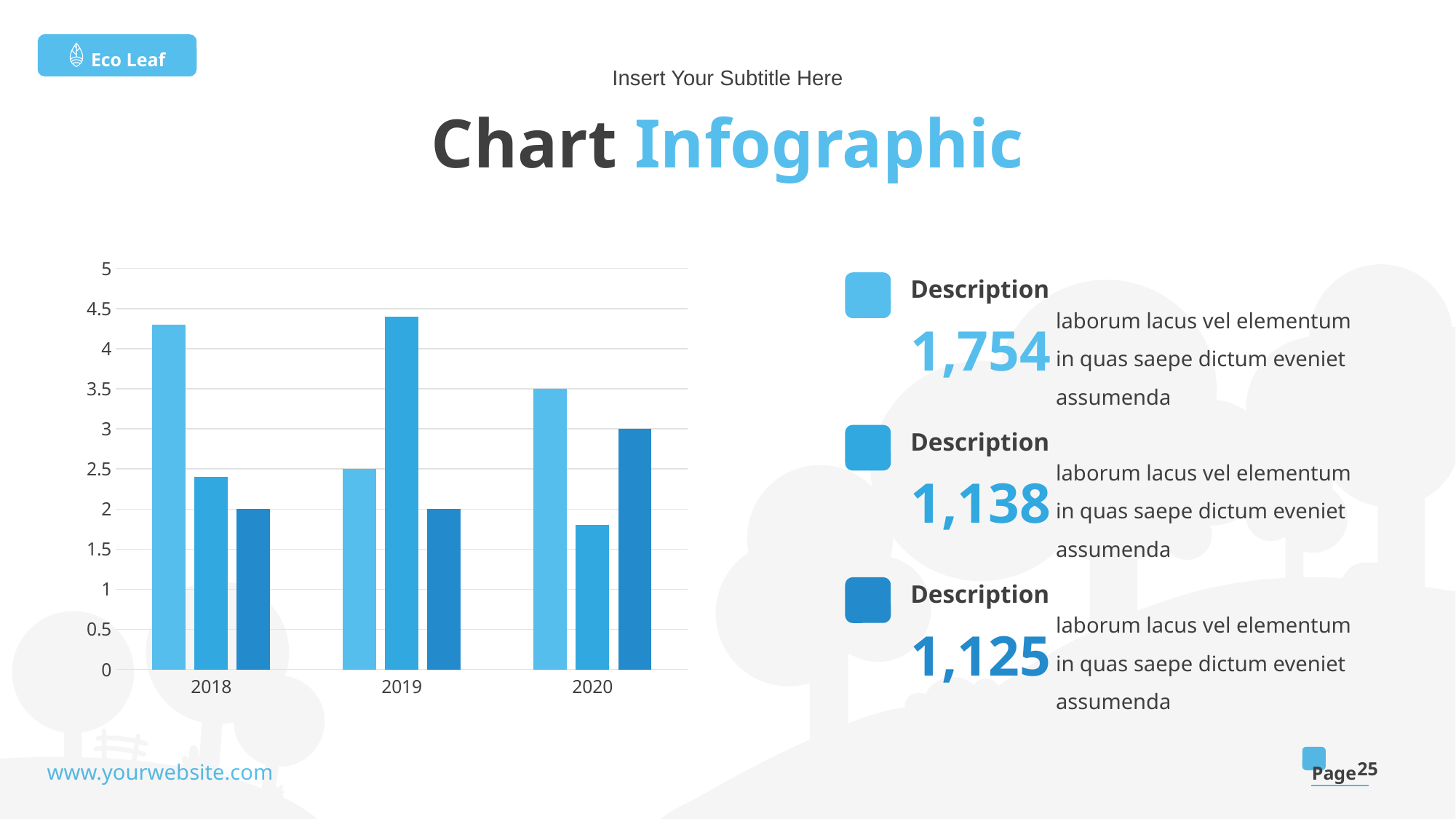
How many year categories are shown on the x axis of the chart? 3 Which year has the tallest medium blue bar? 2019 What is the value of the lightest blue bar for 2020? 3.5 Which year has the shortest lightest blue bar? 2019 What kind of chart is shown on the slide? bar chart How many bars are plotted for each year in the chart? 3 What is the value of the darkest blue bar for 2018? 2 Is the value of the medium blue bar for 2020 greater or less than 2? less Which is larger for 2020: the lightest blue bar or the darkest blue bar? the lightest blue bar What is the value of the darkest blue bar for 2020? 3 What is the value of the lightest blue bar for 2019? 2.5 Is the value of the lightest blue bar for 2018 greater or less than 4? greater